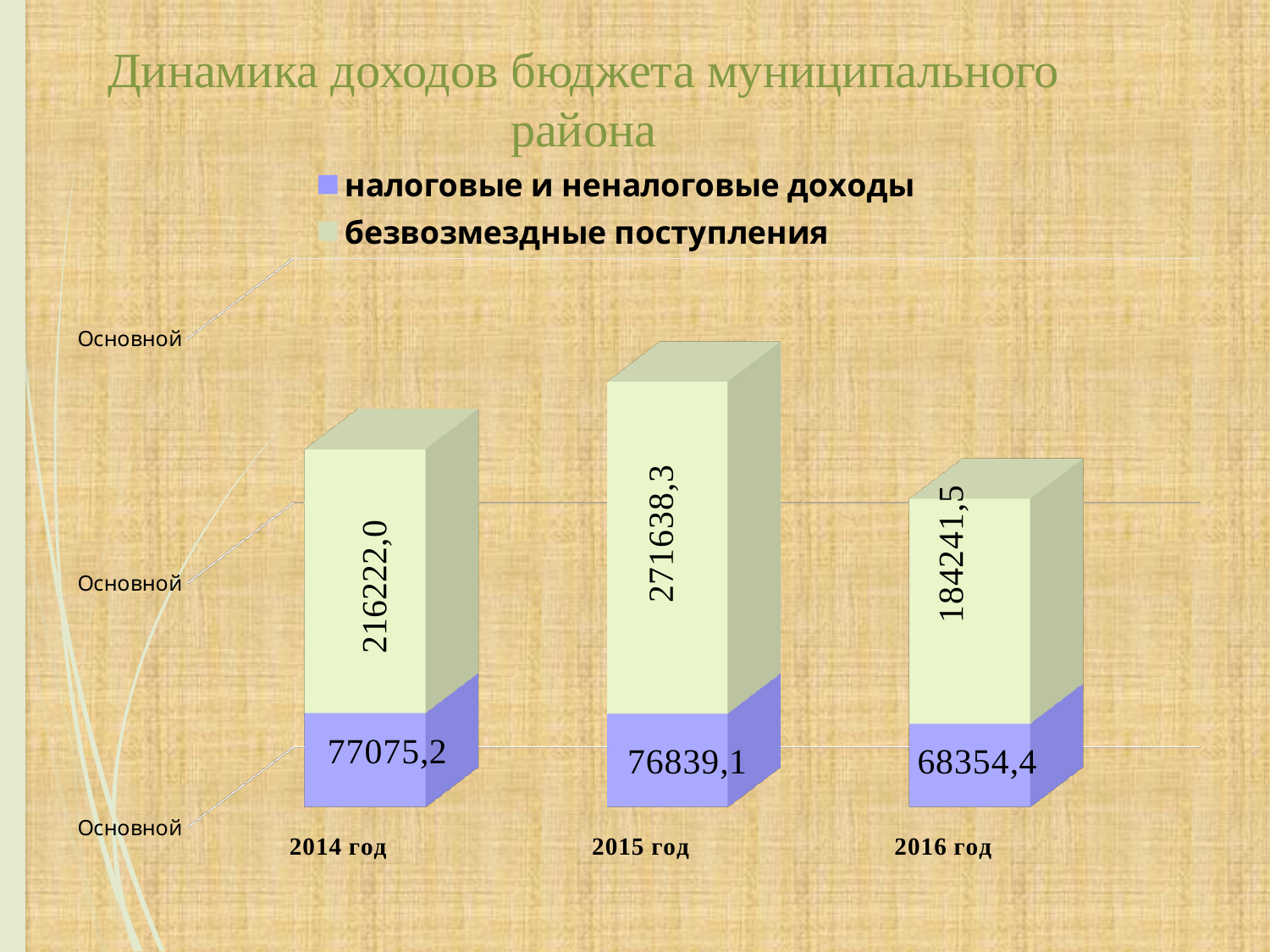
What is the difference between безвозмездные поступления and налоговые и неналоговые доходы in 2014 год? 139146,8 Do the values of налоговые и неналоговые доходы rise or fall from 2014 год to 2016 год? fall How many series does the legend list? 2 What is the value of налоговые и неналоговые доходы for 2016 год? 68354,4 In which year is налоговые и неналоговые доходы the lowest? 2016 год What is the value of безвозмездные поступления for 2015 год? 271638,3 In which year is безвозмездные поступления the highest? 2015 год Which is larger: налоговые и неналоговые доходы in 2014 год or in 2015 год? 2014 год What is the value of безвозмездные поступления for 2014 год? 216222,0 What is the total of the stacked bar for 2016 год? 252595,9 What kind of chart is shown on the slide? stacked bar chart How many years (categories) are shown on the x axis? 3